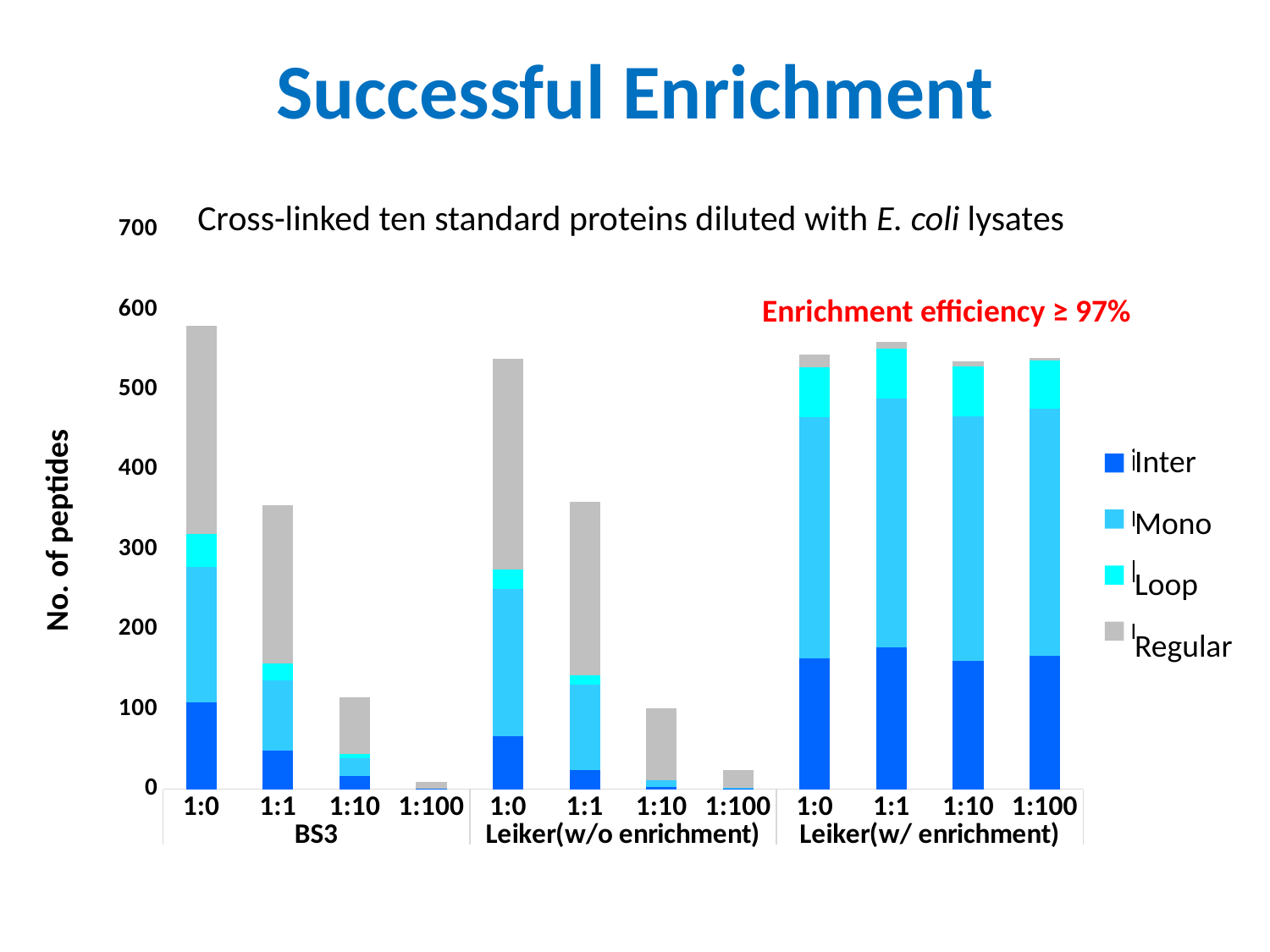
How many dilution ratios are shown within the BS3 group? 4 What is the label of the y axis? No. of peptides How many series does the legend list? 4 What kind of chart is shown on the slide? Stacked bar chart Is the total height of the Leiker(w/o enrichment) 1:100 bar greater or less than 100? less How many bars are plotted in the chart in total? 12 Within the BS3 group, do the bar totals rise or fall from 1:0 to 1:100? fall Is the total height of the Leiker(w/ enrichment) 1:100 bar greater or less than 500? greater Is the total height of the BS3 1:0 bar greater or less than 500? greater At the 1:100 dilution, which has the larger total: Leiker(w/o enrichment) or Leiker(w/ enrichment)? Leiker(w/ enrichment) Which bar has the lowest total number of peptides? BS3 1:100